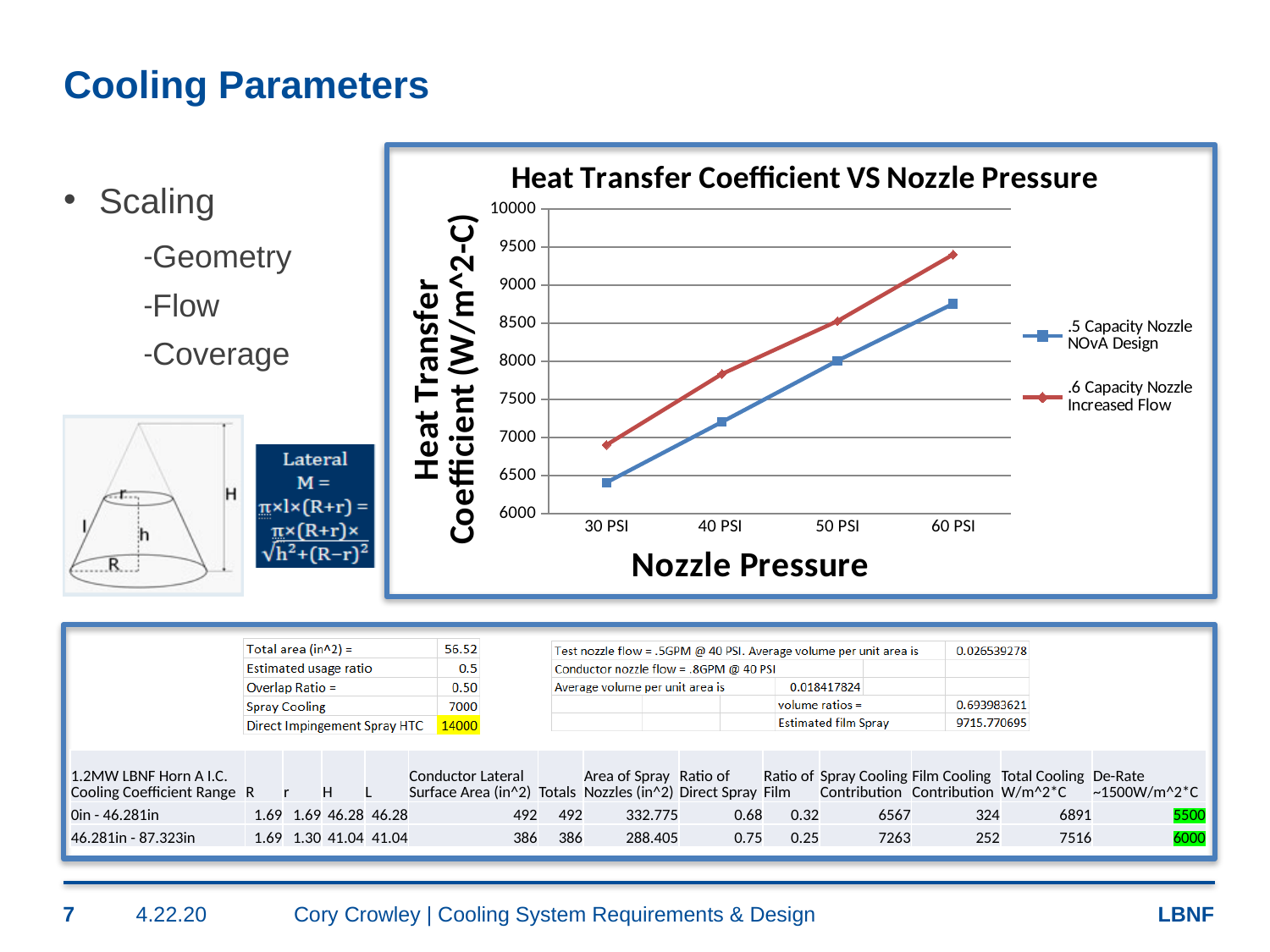
What is the title of the chart on the slide? Heat Transfer Coefficient VS Nozzle Pressure Is the value for the .6 Capacity Nozzle Increased Flow series at 60 PSI greater or less than 9000? greater What is the label of the x axis of the chart? Nozzle Pressure At which nozzle pressure does the .6 Capacity Nozzle Increased Flow series reach its highest value? 60 PSI Is the value for the .5 Capacity Nozzle NOvA Design series at 30 PSI greater or less than 6500? less At which nozzle pressure is the .5 Capacity Nozzle NOvA Design series at its lowest value? 30 PSI What kind of chart is shown on the slide? line chart How many nozzle pressure categories are plotted on the x axis of the chart? 4 How many series does the legend of the Heat Transfer Coefficient VS Nozzle Pressure chart list? 2 At 30 PSI, which series has the higher heat transfer coefficient? .6 Capacity Nozzle Increased Flow Is the value for the .5 Capacity Nozzle NOvA Design series at 60 PSI greater or less than 9000? less Do the heat transfer coefficient values rise or fall as nozzle pressure increases from 30 PSI to 60 PSI? rise